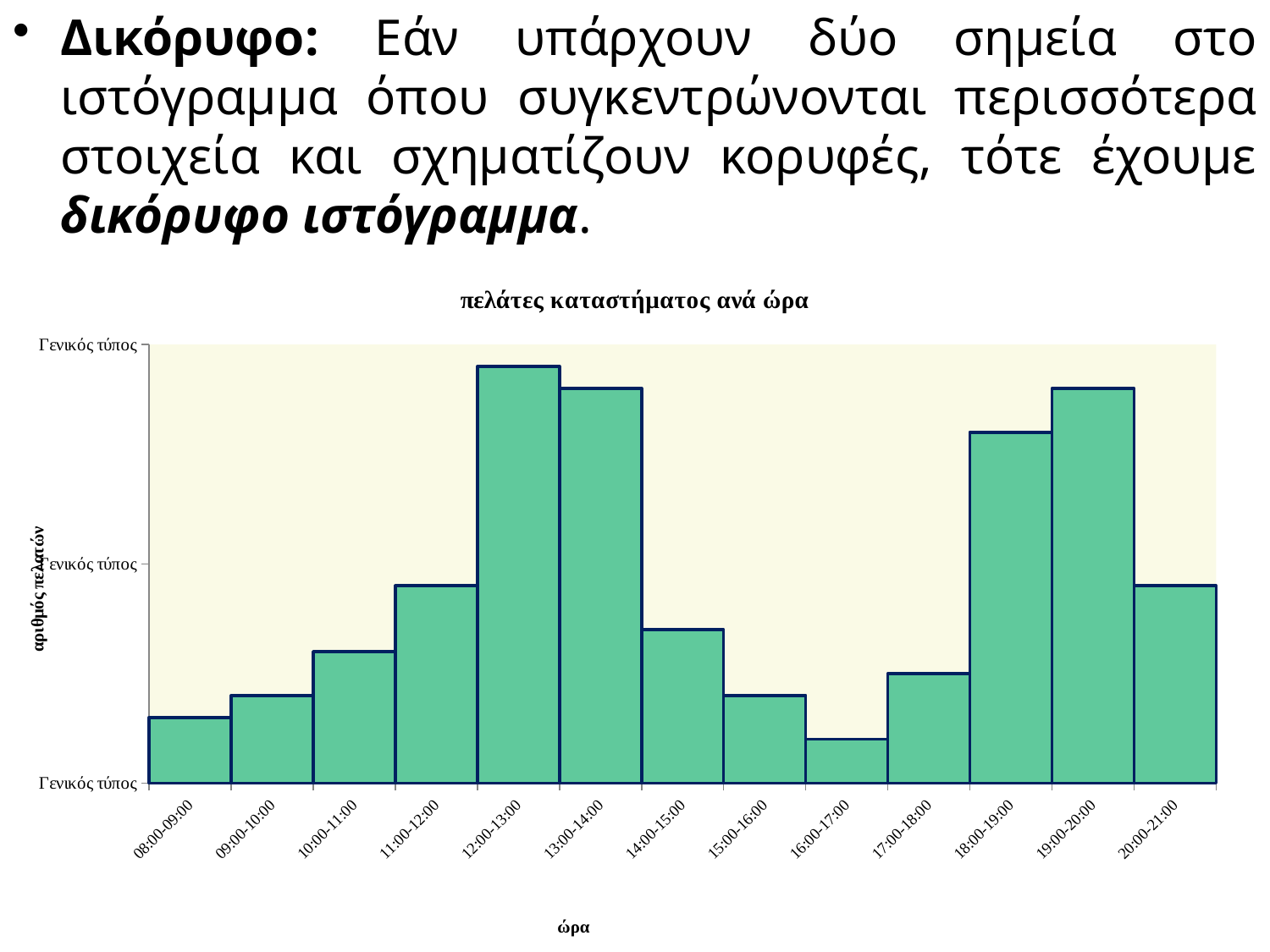
How many time intervals are shown on the x axis of the chart? 13 What kind of chart is shown on the slide? bar chart What is the title of the chart? πελάτες καταστήματος ανά ώρα Which time interval has the lowest number of customers? 16:00-17:00 Which time interval has the highest number of customers? 12:00-13:00 Which has more customers, 12:00-13:00 or 19:00-20:00? 12:00-13:00 Do the values rise or fall from 12:00-13:00 to 16:00-17:00? fall Which has more customers, 13:00-14:00 or 18:00-19:00? 13:00-14:00 What is the label of the x axis of the chart? ώρα Which has more customers, 14:00-15:00 or 15:00-16:00? 14:00-15:00 Do the values rise or fall from 08:00-09:00 to 12:00-13:00? rise